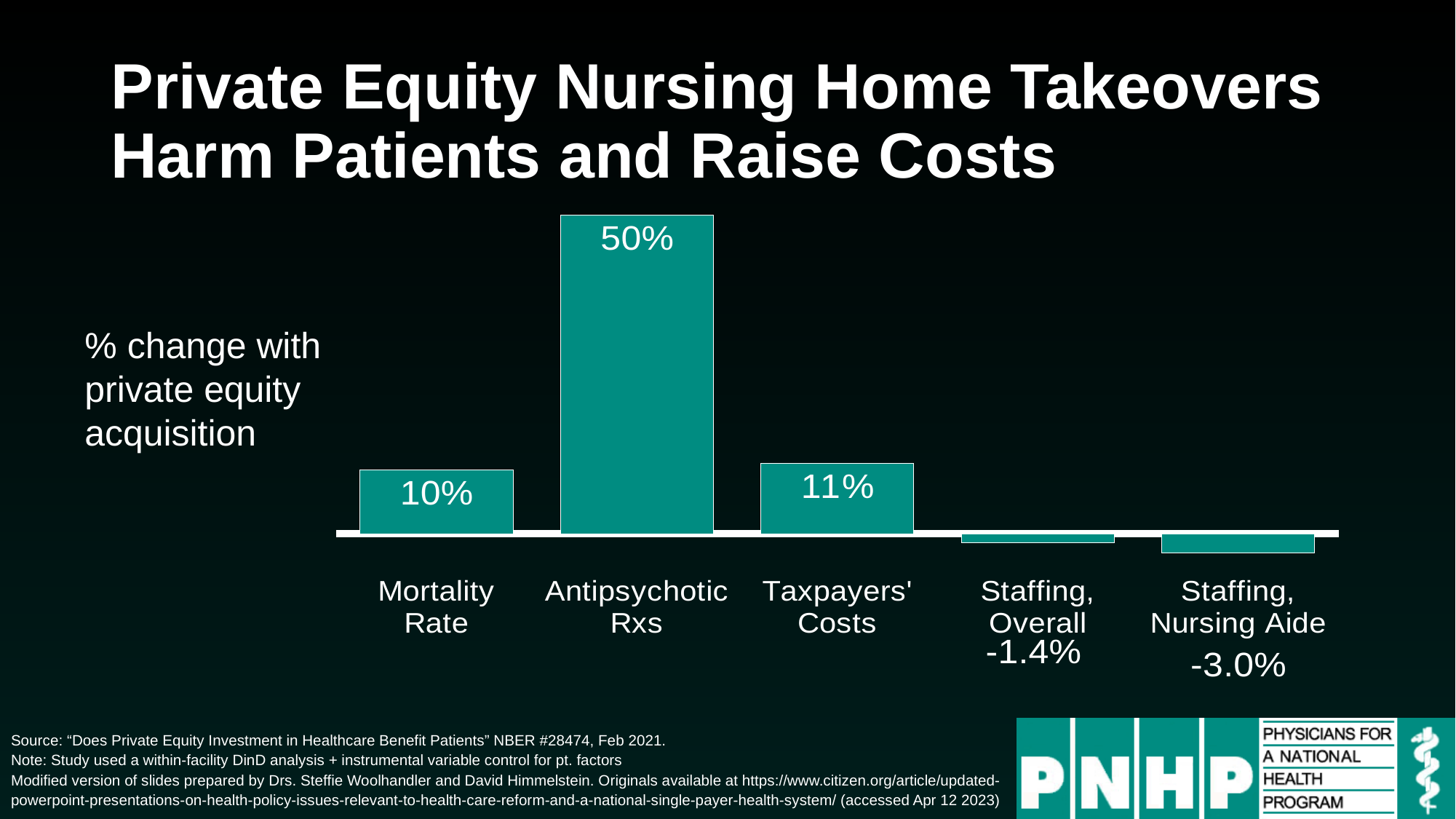
What is the % change in Antipsychotic Rxs with private equity acquisition? 50% What is the % change in Staffing, Nursing Aide with private equity acquisition? -3.0% How many categories show a negative % change? 2 What is the % change in Taxpayers' Costs with private equity acquisition? 11% How many categories are shown in the chart? 5 Which is larger, the % change for Taxpayers' Costs or for Mortality Rate? Taxpayers' Costs What is the difference between the % change for Antipsychotic Rxs and for Mortality Rate? 40% What is the % change in Staffing, Overall with private equity acquisition? -1.4% What kind of chart is shown on the slide? Bar chart Which category shows the lowest % change? Staffing, Nursing Aide Which category shows the largest % change? Antipsychotic Rxs What is the % change in Mortality Rate with private equity acquisition? 10%